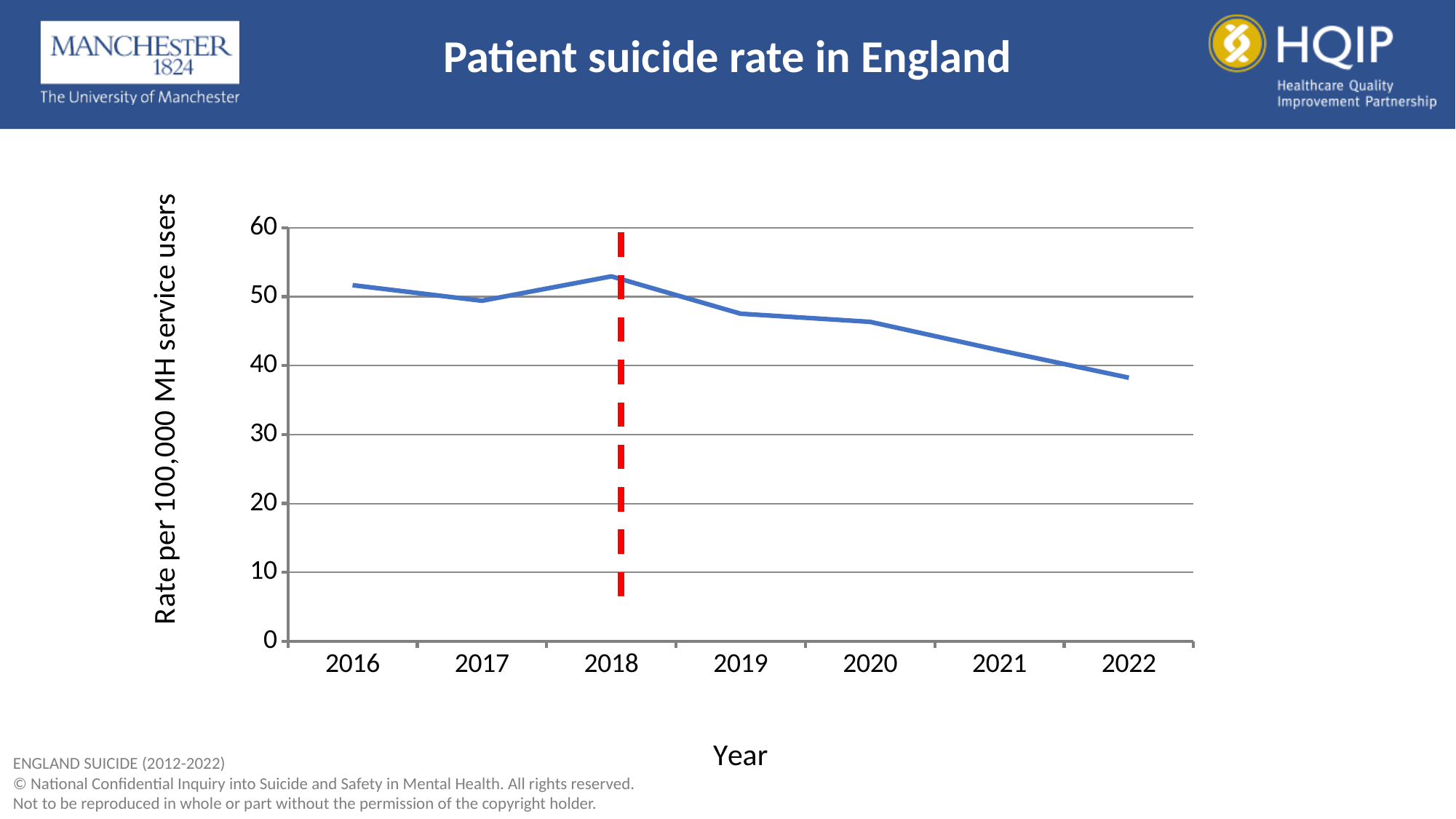
Which year has the larger value, 2018 or 2019? 2018 Do the values generally rise or fall from 2018 to 2022? fall Which year has the highest patient suicide rate? 2018 At which year is the red dashed vertical line placed? 2018 Which year has the lowest patient suicide rate? 2022 Is the value for 2019 greater or less than 50? less What is the label of the y axis? Rate per 100,000 MH service users Is the value for 2021 greater or less than 40? greater Is the value for 2018 greater or less than 50? greater How many years are plotted on the x axis? 7 What kind of chart is shown on the slide? line chart